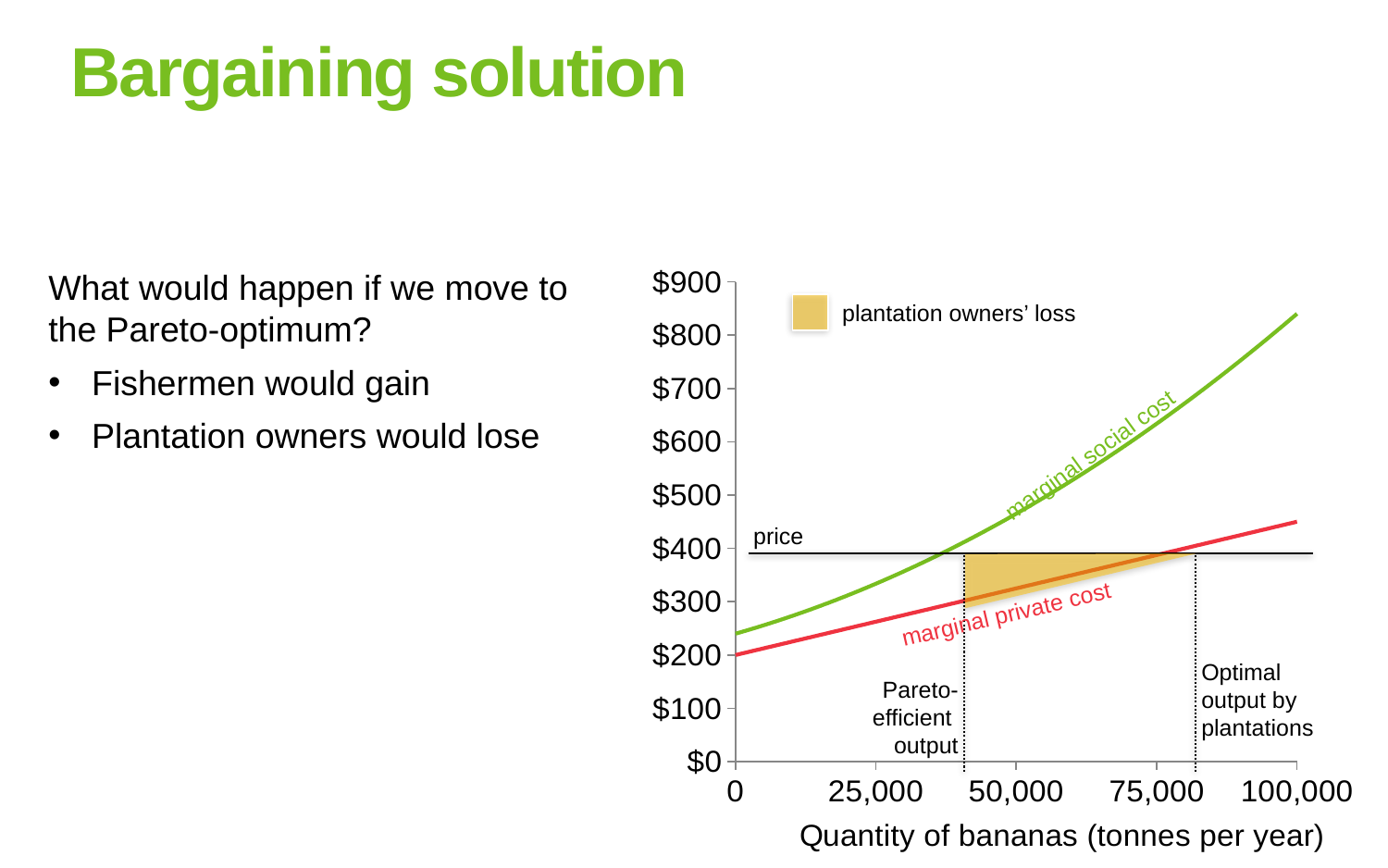
Is the optimal output by plantations greater or less than 75,000 tonnes per year? greater What is the title of the x axis? Quantity of bananas (tonnes per year) Does the marginal private cost line rise or fall as quantity increases? rise How many entries does the legend list? 1 At a quantity of 100,000, is the marginal private cost greater or less than $500? less What does the shaded area in the legend represent? plantation owners' loss Is the price line greater or less than $300? greater Does the marginal social cost curve rise or fall as quantity increases? rise What kind of chart is shown on the slide? line chart At a quantity of 100,000, which is higher: marginal social cost or marginal private cost? marginal social cost